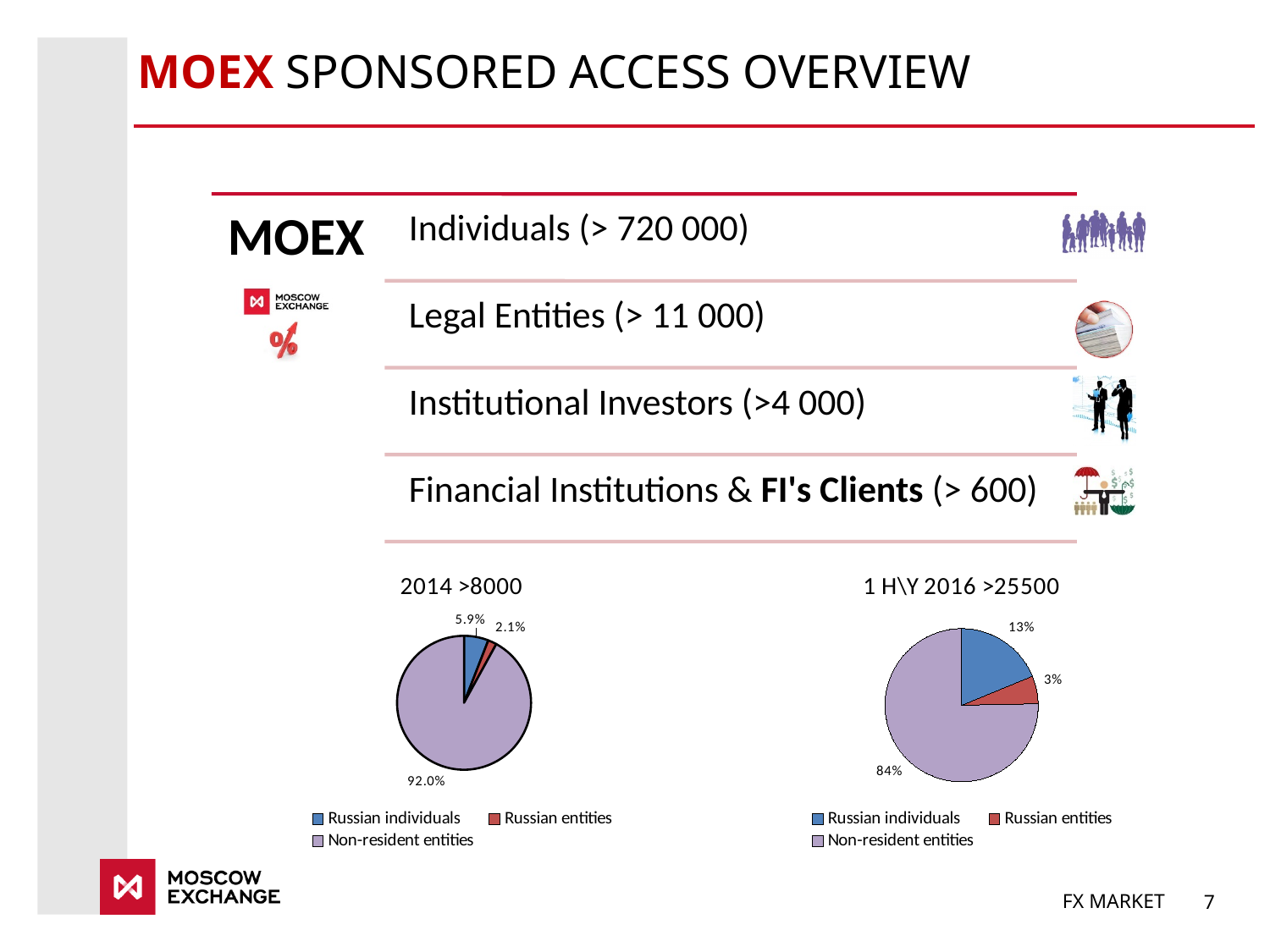
In the '1 H\Y 2016 >25500' pie chart, what share is shown for Non-resident entities? 84% Which is larger: the share of Russian individuals in the '2014 >8000' chart or in the '1 H\Y 2016 >25500' chart? 1 H\Y 2016 >25500 In the '1 H\Y 2016 >25500' pie chart, which category has the smallest slice? Russian entities How many categories does the legend of the '1 H\Y 2016 >25500' pie chart list? 3 In the '2014 >8000' pie chart, what share is shown for Russian entities? 2.1% What type of chart is used for the '2014 >8000' data? Pie chart In the '2014 >8000' pie chart, which category has the largest slice? Non-resident entities In the '2014 >8000' pie chart, what share is shown for Non-resident entities? 92.0% In the '1 H\Y 2016 >25500' pie chart, what share is shown for Russian entities? 3% In the '1 H\Y 2016 >25500' pie chart, what share is shown for Russian individuals? 13% In the '2014 >8000' pie chart, what share is shown for Russian individuals? 5.9% In the '1 H\Y 2016 >25500' pie chart, what is the difference between the shares of Russian individuals and Russian entities? 10%